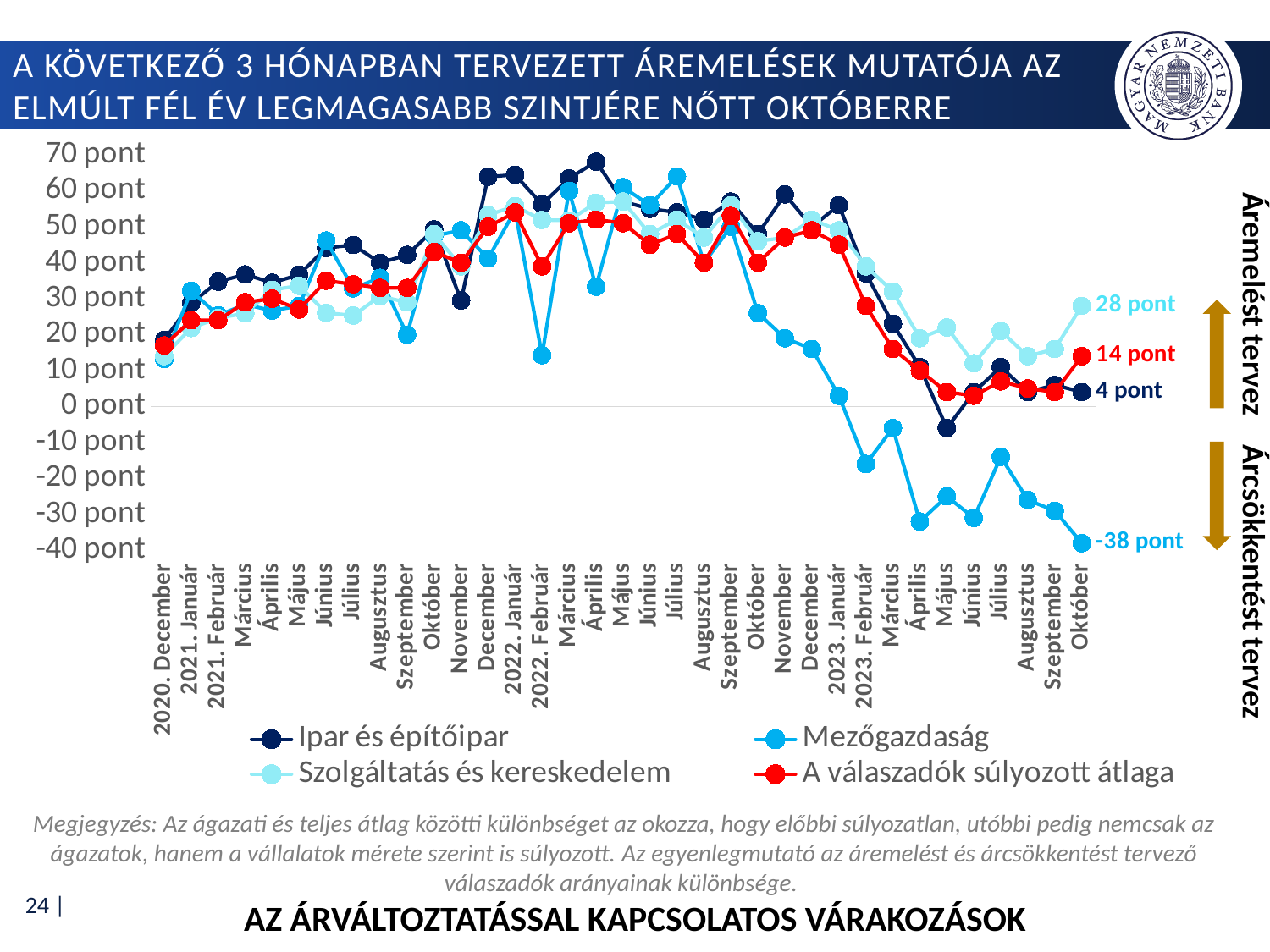
Which series has the highest value in Október 2023? Szolgáltatás és kereskedelem Is the value for Ipar és építőipar in 2022. Április greater or less than 60 pont? greater Which is larger in Október 2023: Ipar és építőipar or Mezőgazdaság? Ipar és építőipar Which series has the lowest value in Október 2023? Mezőgazdaság Does the Mezőgazdaság series rise or fall from 2023. Január to Október 2023? fall What is the value for A válaszadók súlyozott átlaga in Október 2023? 14 pont What is the value for Mezőgazdaság in Október 2023? -38 pont What kind of chart is shown on the slide? line chart What is the difference between Szolgáltatás és kereskedelem and Mezőgazdaság in Október 2023? 66 pont What is the value for Ipar és építőipar in Október 2023? 4 pont What is the value for Szolgáltatás és kereskedelem in Október 2023? 28 pont How many series does the legend list? 4